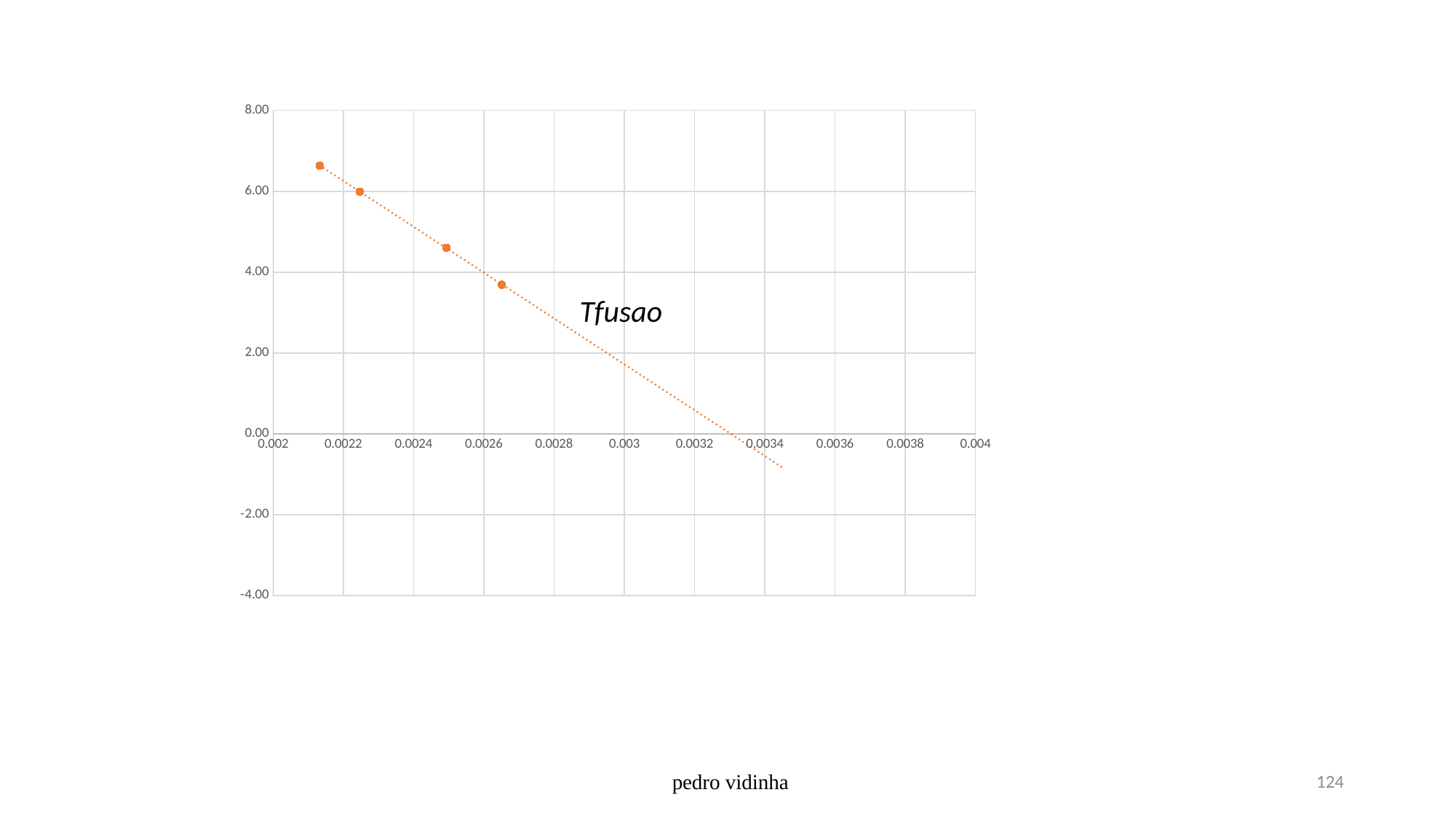
How many data points are plotted on the chart? 4 What text label is written next to the trendline on the chart? Tfusao Is the value of the rightmost data point greater or less than 2.00? greater What is the highest value shown on the y-axis? 8.00 Is the value of the rightmost data point greater or less than 4.00? less What kind of chart is shown on the slide? scatter chart Which data point has the highest value, the leftmost or the rightmost? the leftmost What colour are the data points and the dotted trendline? orange Is the value of the leftmost data point greater or less than 6.00? greater Do the plotted values rise or fall as the x-axis value increases? fall